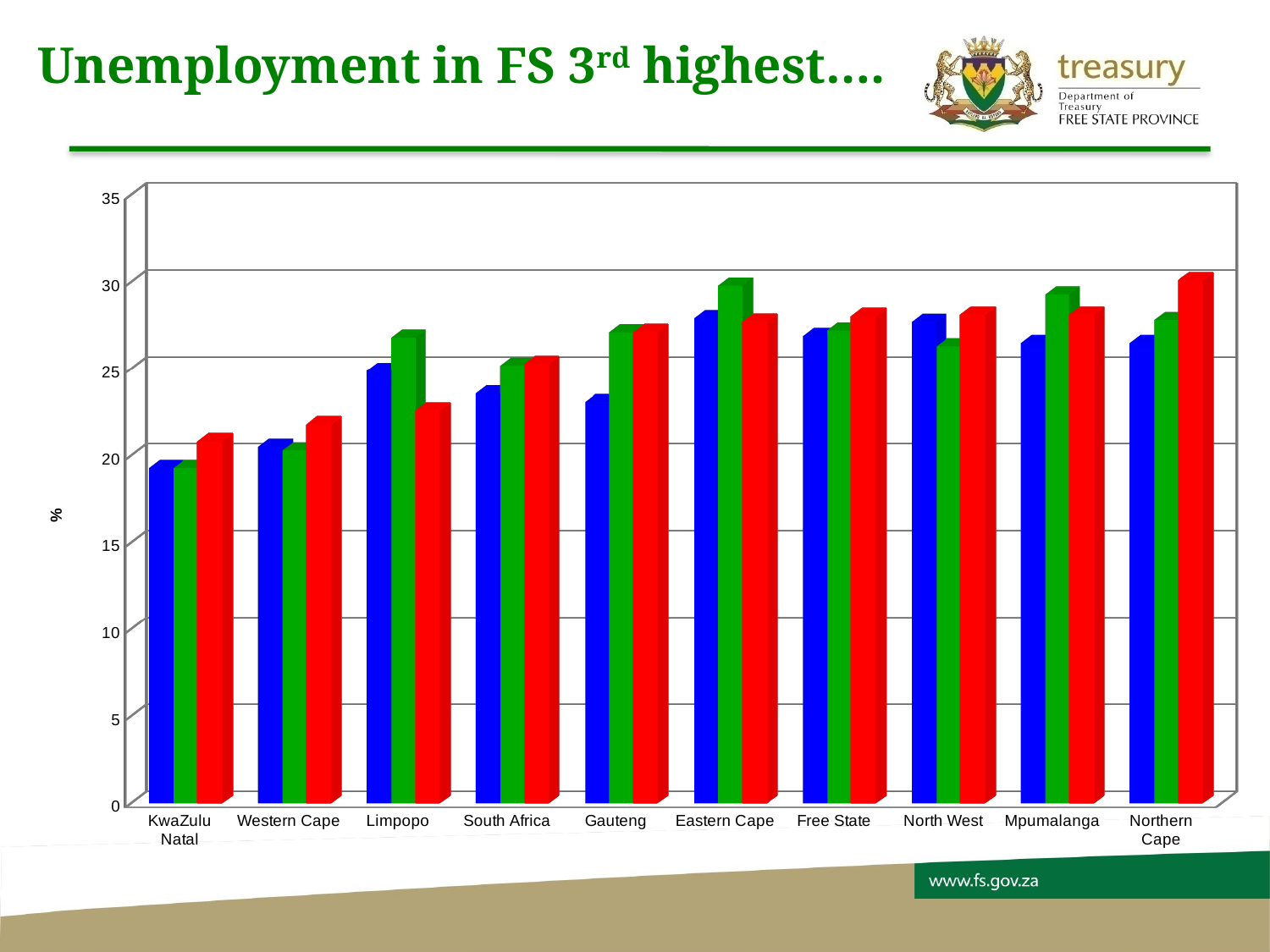
For Limpopo, which is larger: the green bar or the red bar? the green bar What is the title of the slide containing the chart? Unemployment in FS 3rd highest.... Is the value of the blue bar for Gauteng greater or less than 25? less Which category has the highest red bar? Northern Cape Is the value of the green bar for Eastern Cape greater or less than 25? greater Which category has the lowest blue bar? KwaZulu Natal How many categories are shown along the x axis of the chart? 10 Is the value of the red bar for Northern Cape greater or less than 25? greater What label is shown on the vertical axis of the chart? % How many bars are plotted for each category in the chart? 3 What kind of chart is shown on the slide? bar chart